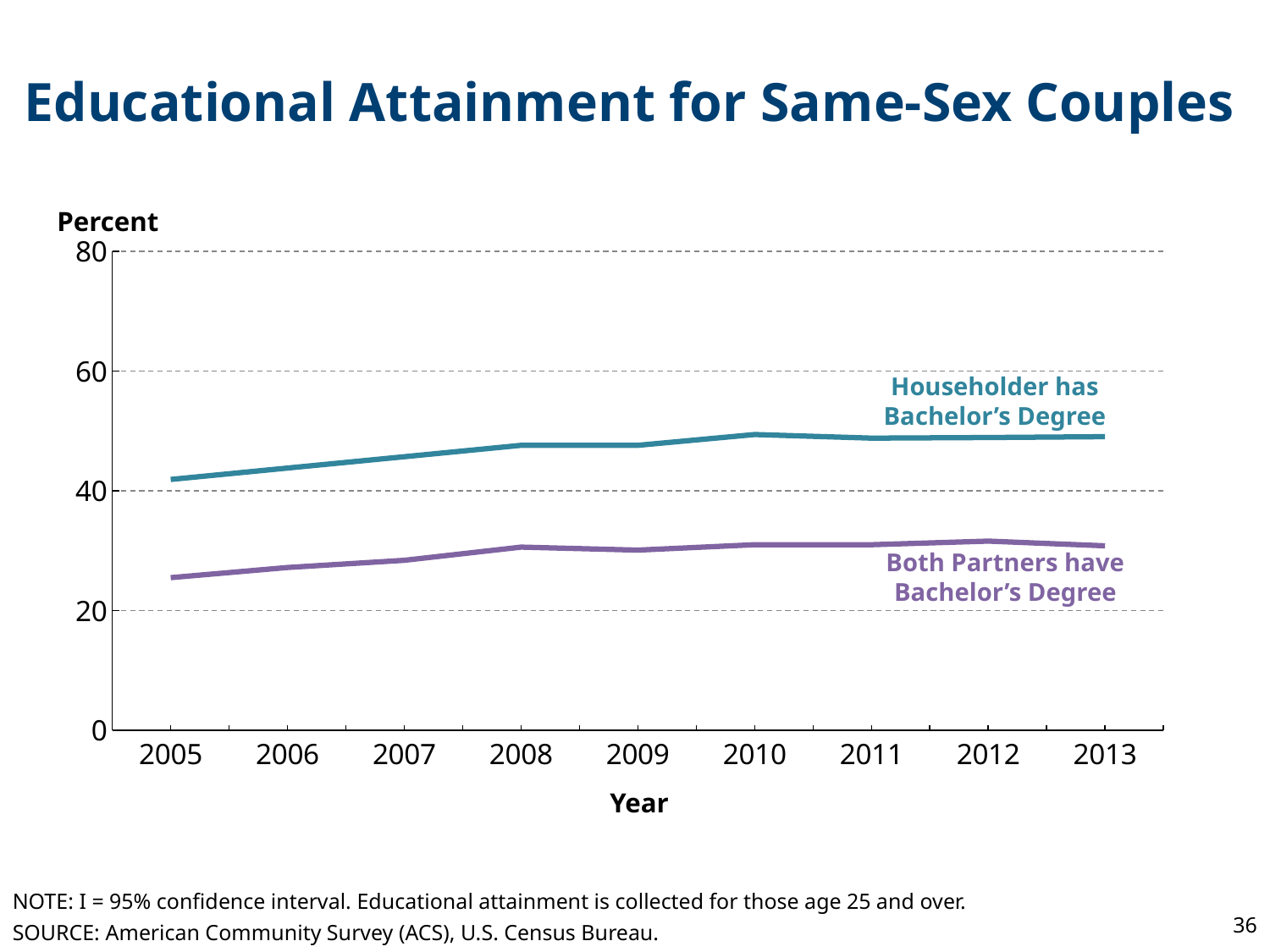
How many data series are plotted on the chart? 2 In which year is the "Householder has Bachelor's Degree" series at its lowest? 2005 What kind of chart is shown on the slide? line chart Which series is higher in 2010, "Householder has Bachelor's Degree" or "Both Partners have Bachelor's Degree"? Householder has Bachelor's Degree Is the value for "Both Partners have Bachelor's Degree" in 2013 greater or less than 40? less In which year is the "Both Partners have Bachelor's Degree" series at its lowest? 2005 How many years are plotted along the x axis? 9 Is the value for "Householder has Bachelor's Degree" in 2010 greater or less than 40? greater Is the value for "Householder has Bachelor's Degree" in 2013 greater or less than 60? less What is the title of the chart on the slide? Educational Attainment for Same-Sex Couples Overall, does the "Householder has Bachelor's Degree" series rise or fall from 2005 to 2013? rise